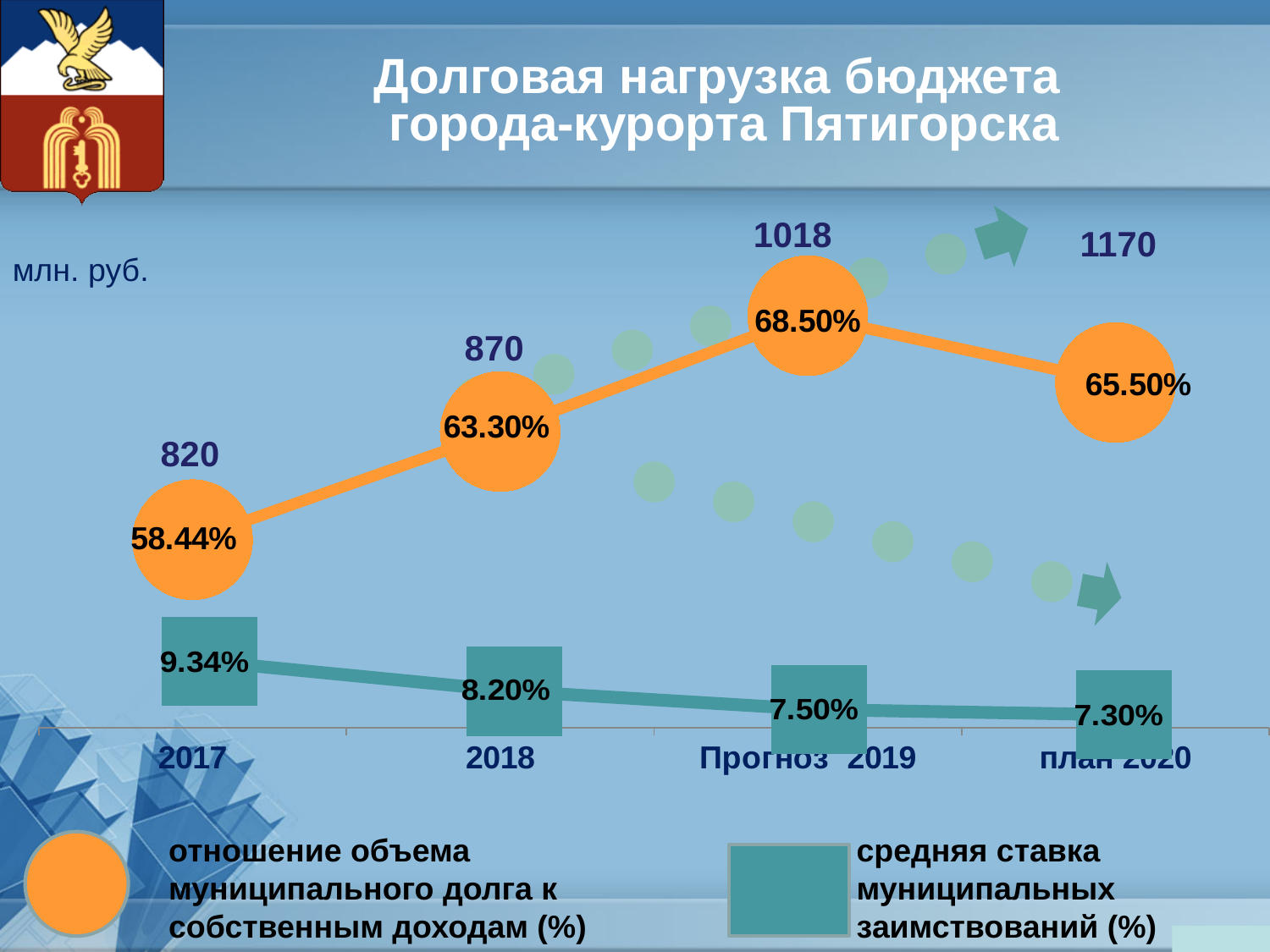
What is the difference between the average rate of municipal borrowings in 2017 and in 2018? 1.14% Does the average rate of municipal borrowings rise or fall from 2017 to план 2020? fall What is the debt volume in млн. руб. shown above the point for план 2020? 1170 Which is larger: the ratio of municipal debt to own revenues in 2018 or in план 2020? план 2020 How many categories are shown on the x axis? 4 What is the ratio of municipal debt to own revenues for Прогноз 2019? 68.50% What is the average rate of municipal borrowings (teal series) for 2018? 8.20% In which year is the ratio of municipal debt to own revenues the highest? Прогноз 2019 What is the ratio of municipal debt to own revenues (orange series) for 2017? 58.44% In which year is the average rate of municipal borrowings the lowest? план 2020 How many series does the legend list? 2 What is the average rate of municipal borrowings for план 2020? 7.30%